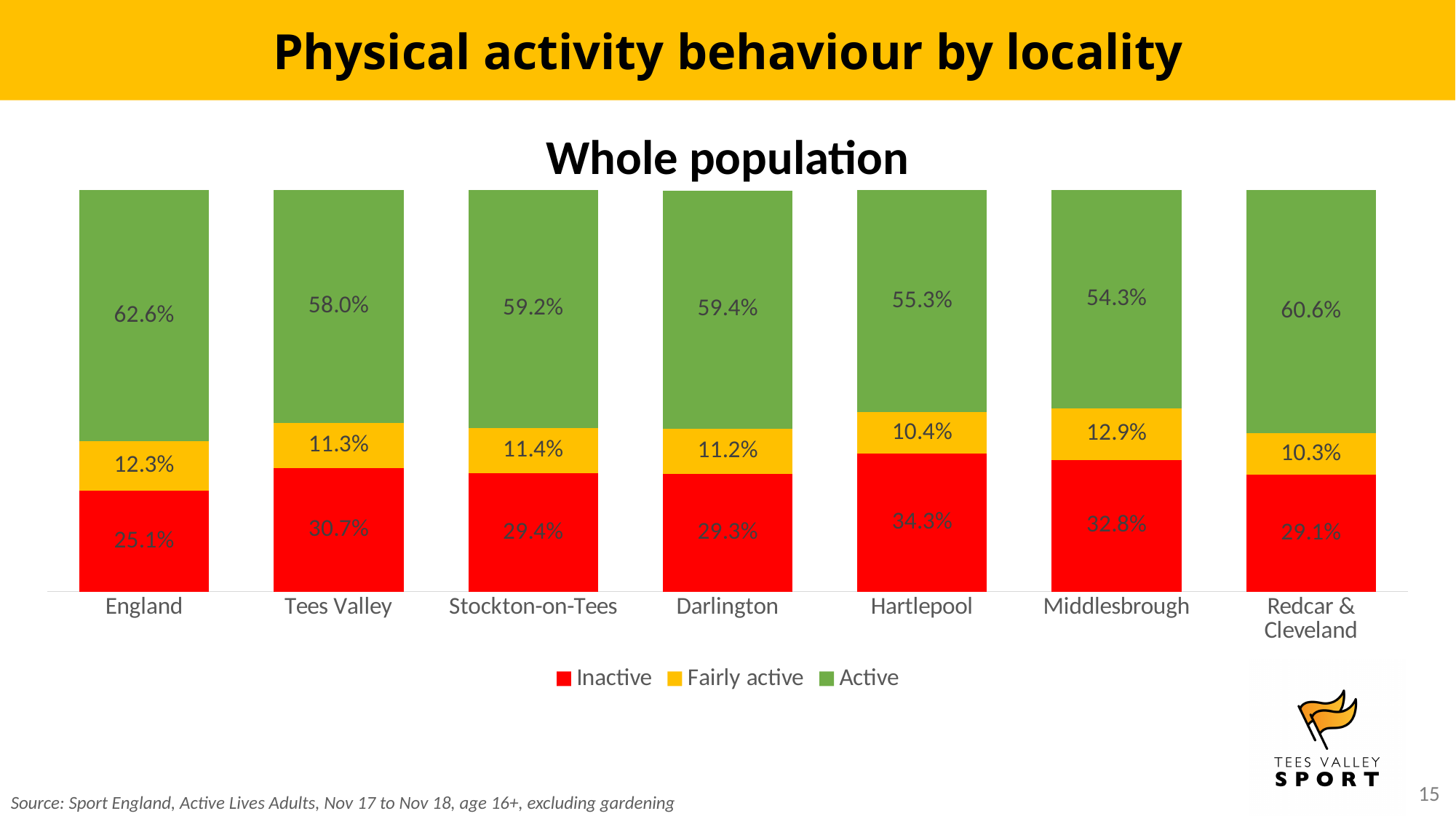
What kind of chart is shown? Stacked bar chart How many series does the legend list? 3 How many localities are shown on the x axis? 7 What is the total of the stacked bar for Tees Valley? 100.0% What is the Active value for Redcar & Cleveland? 60.6% Which locality has the highest Inactive value? Hartlepool What is the Inactive value for Hartlepool? 34.3% What is the Fairly active value for Darlington? 11.2% Which locality has the highest Fairly active value? Middlesbrough What is the difference between the Inactive value for Hartlepool and the Inactive value for England? 9.2 percentage points Which locality has the lowest Active value? Middlesbrough Which is larger, the Inactive value for Middlesbrough or the Inactive value for Tees Valley? Middlesbrough